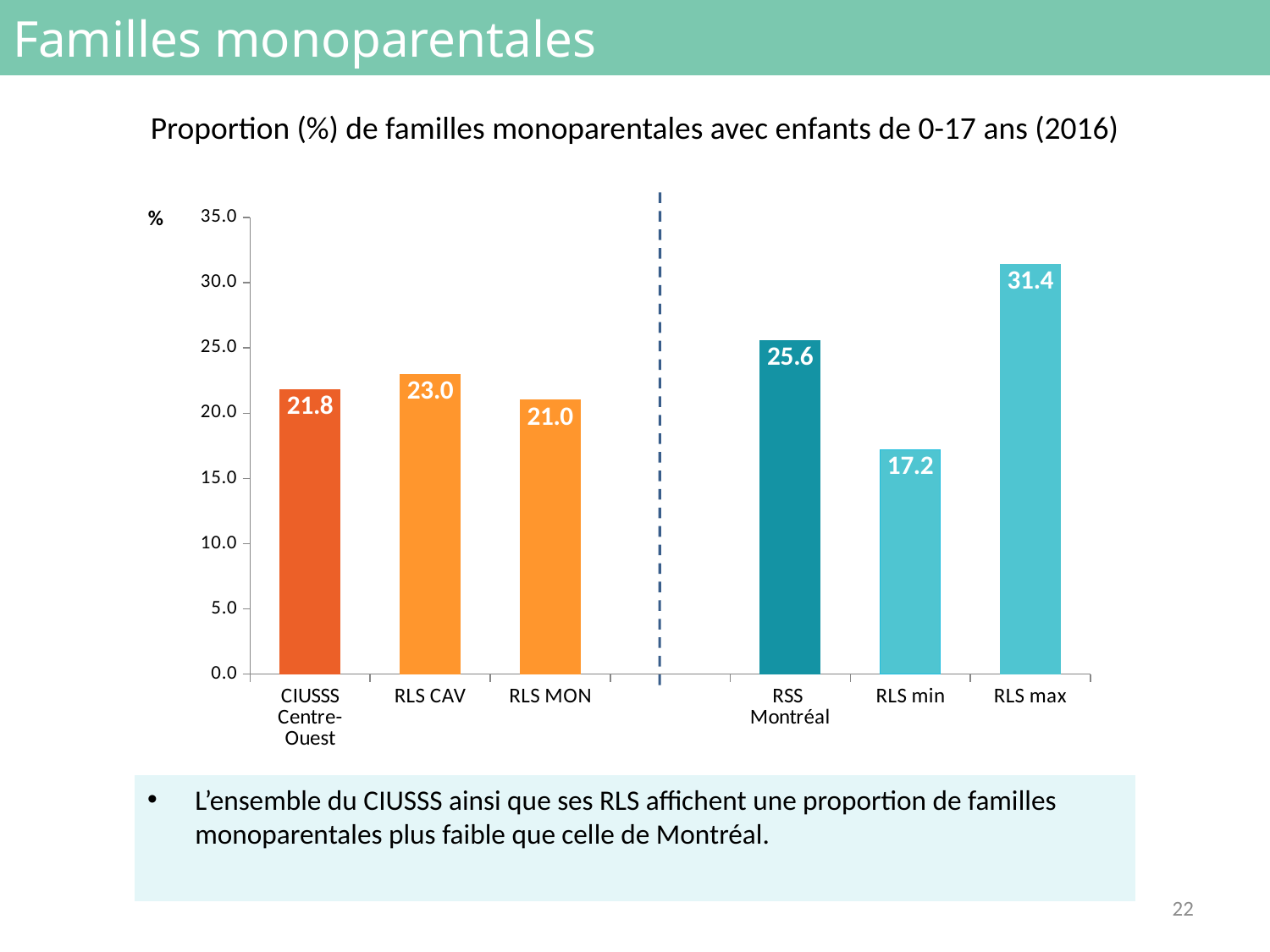
What is the value for RLS min? 17.2 What is the value for RLS CAV? 23.0 What is the difference between the values for RLS max and RLS min? 14.2 Which category has the highest value? RLS max What is the difference between the values for RSS Montréal and CIUSSS Centre-Ouest? 3.8 What kind of chart is shown on the slide? Bar chart What is the title of the chart? Proportion (%) de familles monoparentales avec enfants de 0-17 ans (2016) What is the value for RSS Montréal? 25.6 What is the value for CIUSSS Centre-Ouest? 21.8 How many bars are shown in the chart? 6 Which is larger, the value for RLS CAV or the value for RLS MON? RLS CAV Which category has the lowest value? RLS min